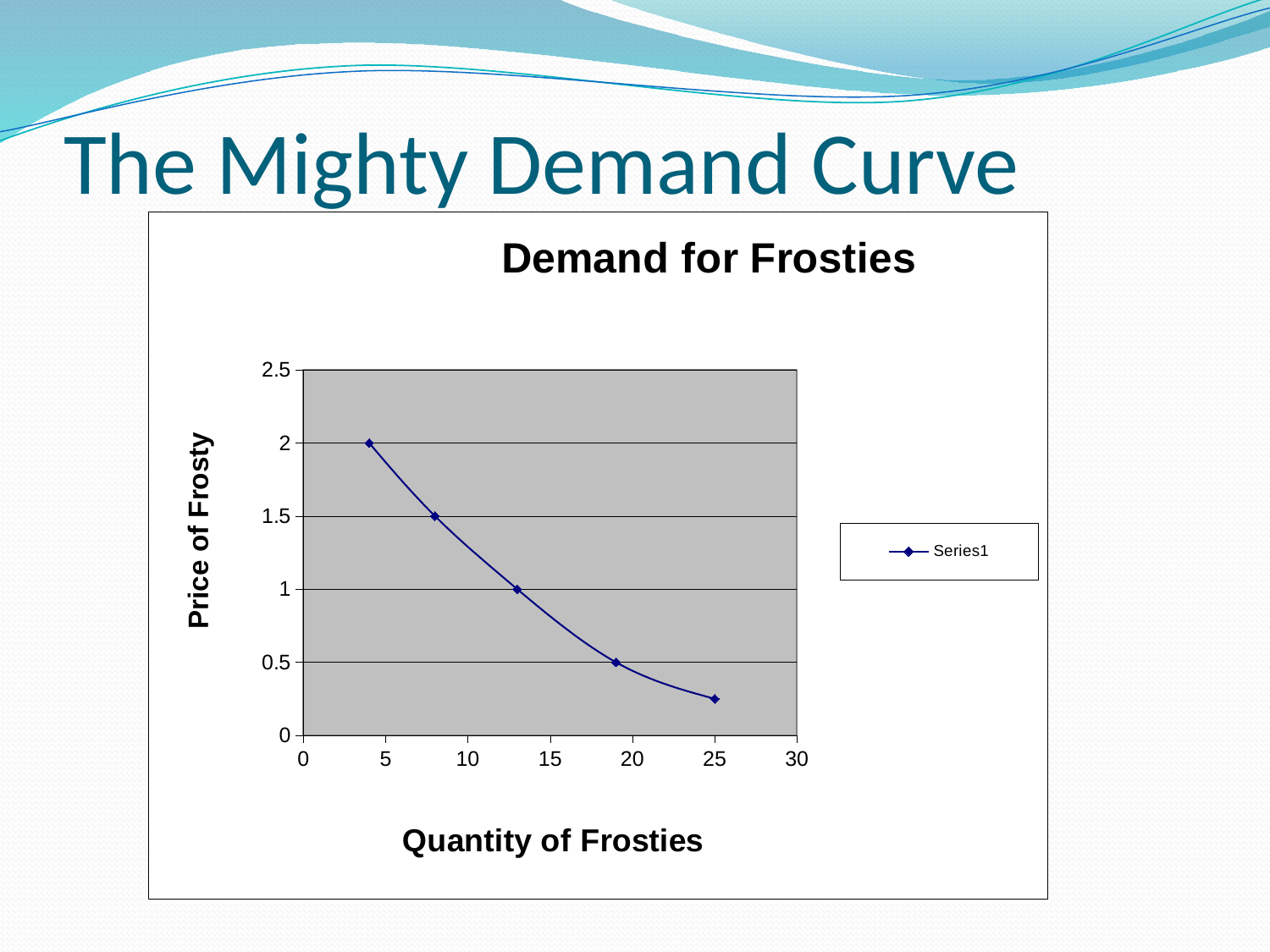
How many series does the legend list? 1 Is the quantity at a price of 2 greater or less than 5? less What is the highest price plotted on the curve? 2 What is the title of the chart? Demand for Frosties Is the price at a quantity of 25 greater or less than 0.5? less Is the quantity at a price of 0.5 greater or less than 20? less What kind of chart is shown? line chart Does the price rise or fall as the quantity of Frosties increases? fall Which is larger: the price at the leftmost point or the price at the rightmost point? the leftmost point What is the label of the y axis? Price of Frosty How many data points are plotted on the curve? 5